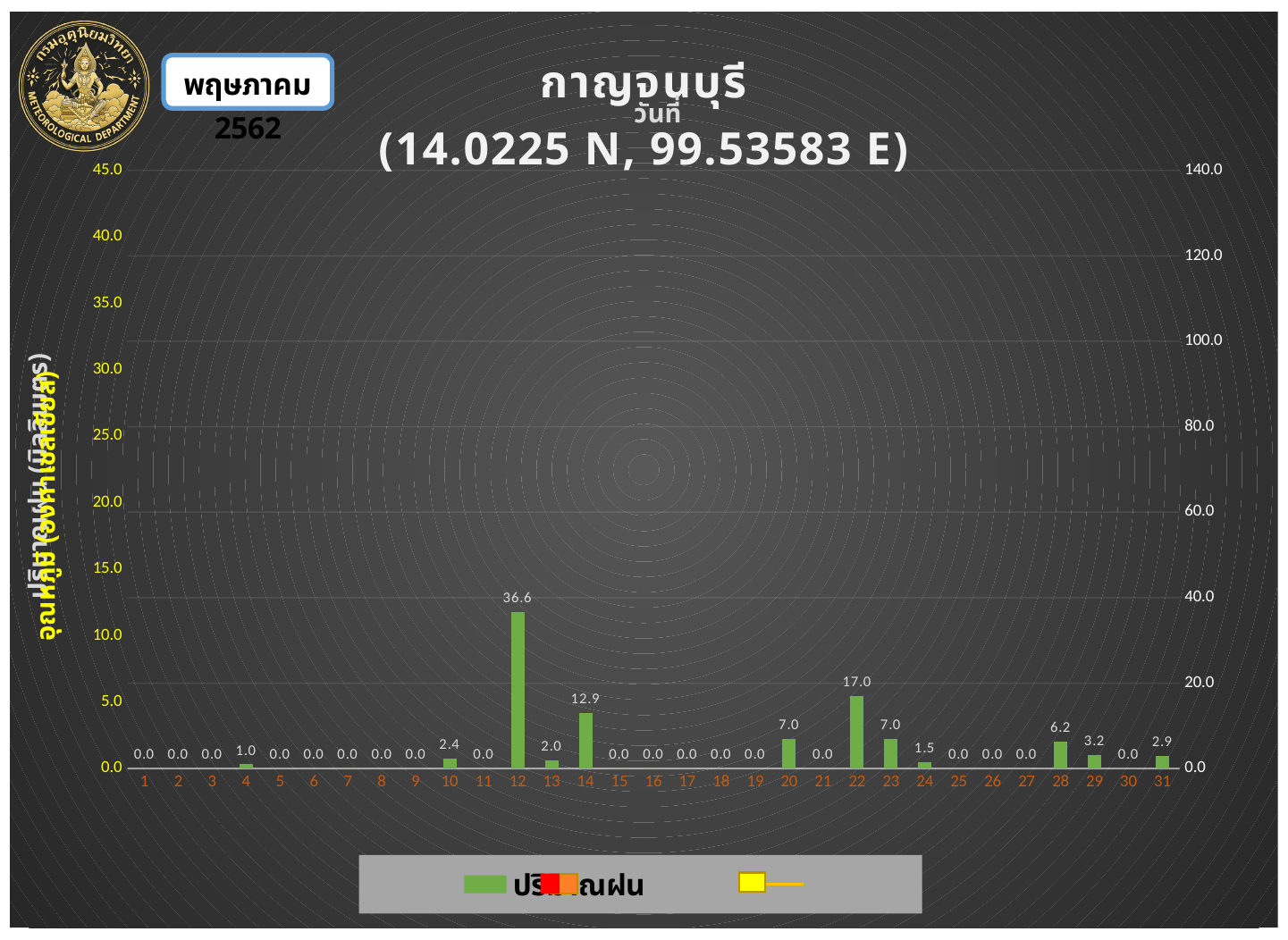
What kind of chart is shown on the slide? bar chart How many days are shown on the x axis? 31 Which day has the larger rainfall value, day 10 or day 24? day 10 What is the rainfall value shown for day 22? 17.0 Which day has the larger rainfall value, day 20 or day 28? day 20 Which day has the highest rainfall value? 12 What is the difference between the rainfall values for day 12 and day 22? 19.6 What is the rainfall value shown for day 12? 36.6 What is the difference between the rainfall values for day 14 and day 13? 10.9 What is the rainfall value shown for day 14? 12.9 What coordinates are given in the chart title? 14.0225 N, 99.53583 E What is the rainfall value shown for day 29? 3.2